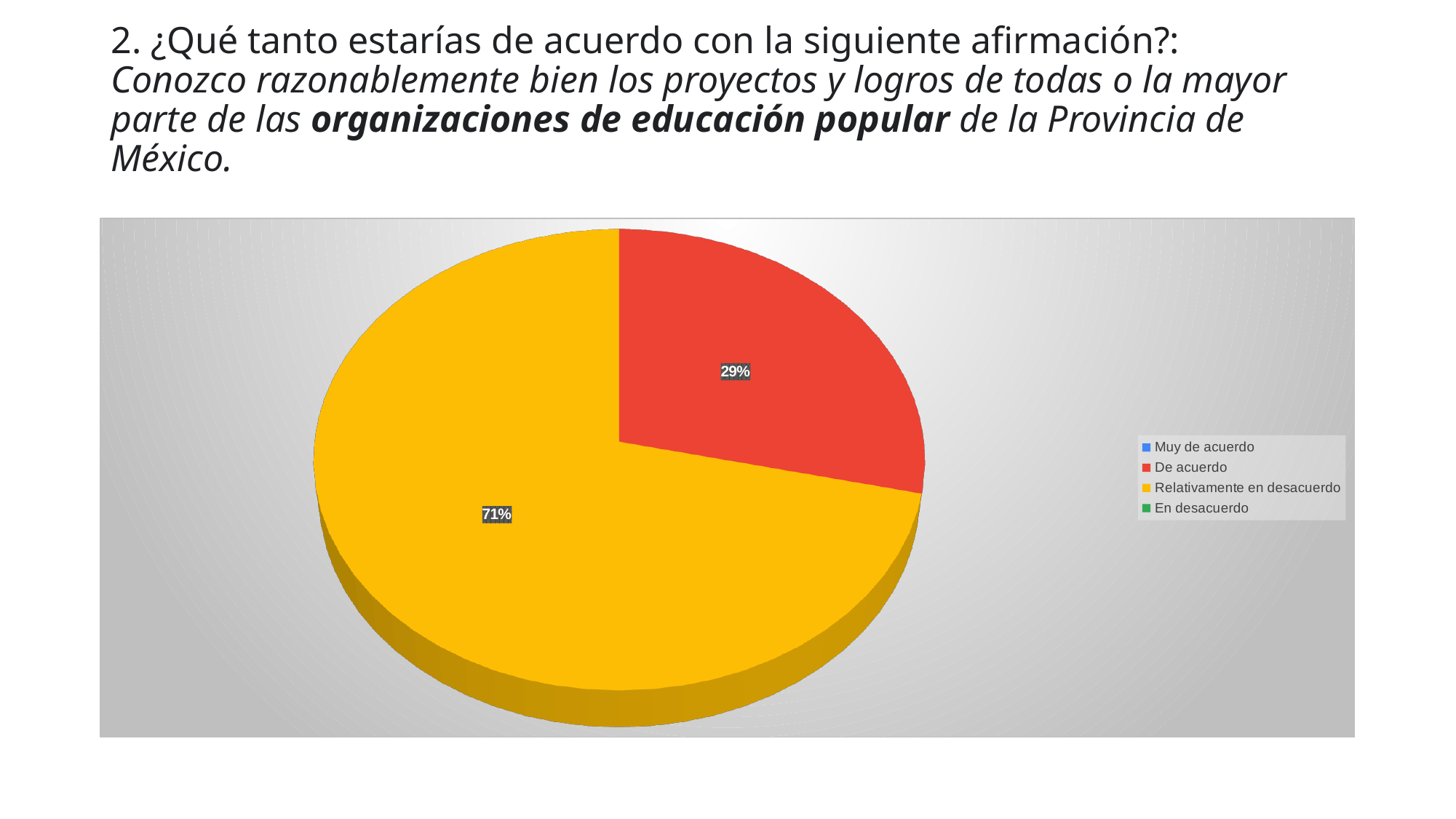
How many entries does the legend list? 4 What share of the pie does "Relativamente en desacuerdo" have? 71% What kind of chart is shown on the slide? Pie chart What share of the pie does "De acuerdo" have? 29% What colour is the "De acuerdo" slice? Red What colour is the "Relativamente en desacuerdo" slice? Yellow Which category has the largest slice of the pie? Relativamente en desacuerdo What is the difference in percentage points between the "Relativamente en desacuerdo" slice and the "De acuerdo" slice? 42% What is the total of the two labelled slices? 100% How many slices are visible in the pie? 2 Which is larger, the slice for "De acuerdo" or the slice for "Relativamente en desacuerdo"? Relativamente en desacuerdo